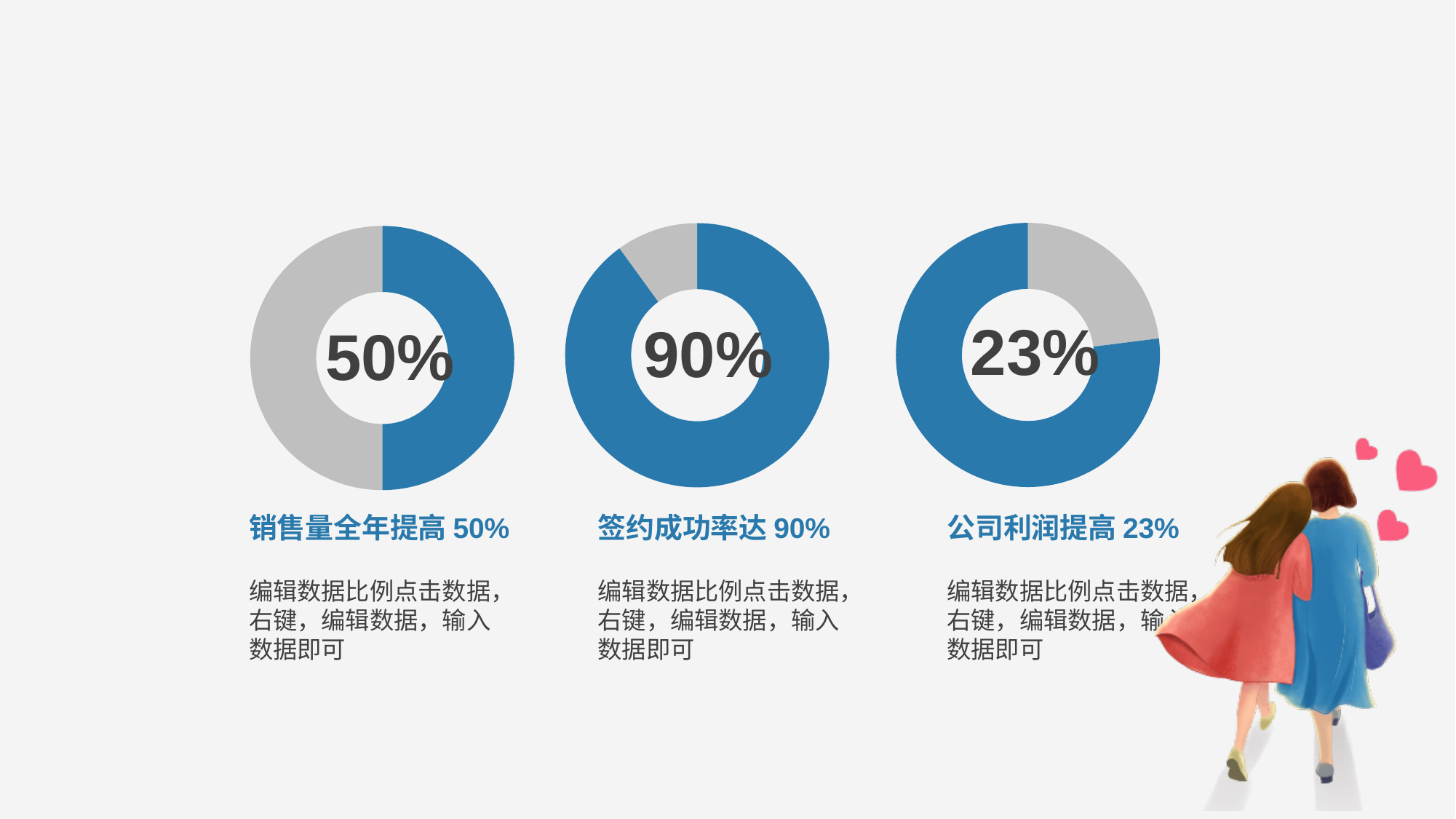
What two colours are used for the segments of the donut charts? Blue and grey Which of the three donut charts shows the lowest printed percentage? The right chart (23%) Which of the three donut charts shows the highest printed percentage? The middle chart (90%) What is the difference between the percentage in the left donut chart and the percentage in the right donut chart? 27 percentage points Which is larger, the value in the left donut chart or the value in the right donut chart? The left donut chart (50%) What value is printed in the centre of the left donut chart? 50% What value is printed in the centre of the middle donut chart? 90% How many donut charts are shown on the slide? 3 What kind of chart is used for each of the three figures on the slide? Donut (pie) chart What value is printed in the centre of the right donut chart? 23% What is the caption under the middle donut chart? 签约成功率达 90% What is the difference between the percentage in the middle donut chart and the percentage in the left donut chart? 40 percentage points